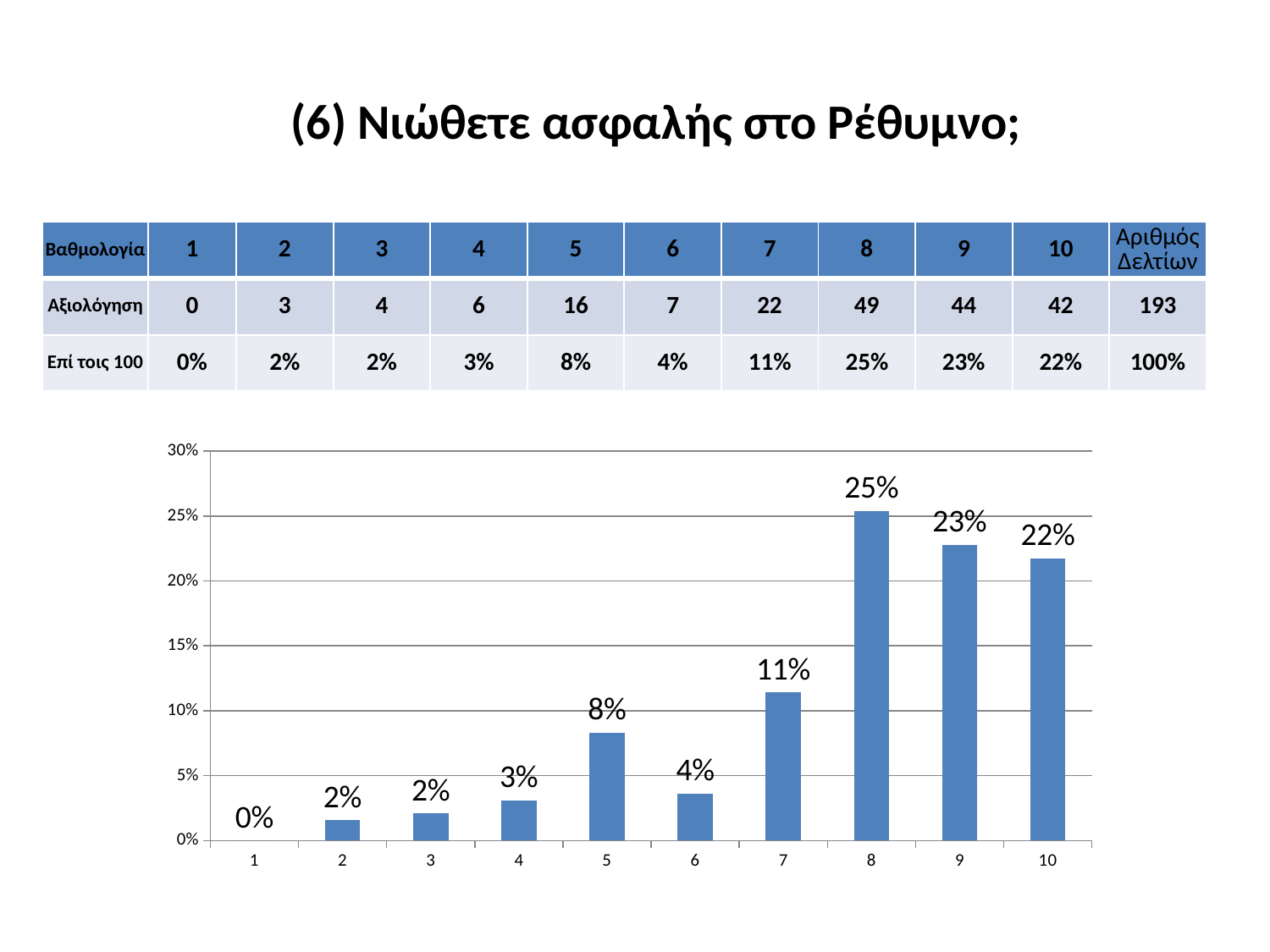
What percentage is shown for rating 8 in the bar chart? 25% What is the difference between the percentages for rating 8 and rating 7? 14% Which has a larger percentage, rating 9 or rating 10? 9 Is the value for rating 6 greater or less than 5%? less Which rating has the highest percentage in the bar chart? 8 What is the maximum value shown on the y axis of the bar chart? 30% Do the percentages generally rise or fall from rating 1 to rating 8? rise What kind of chart is shown on the slide? bar chart What percentage is shown for rating 7 in the bar chart? 11% How many rating categories are shown on the x axis of the bar chart? 10 What percentage is shown for rating 5 in the bar chart? 8% Which rating has the lowest percentage in the bar chart? 1